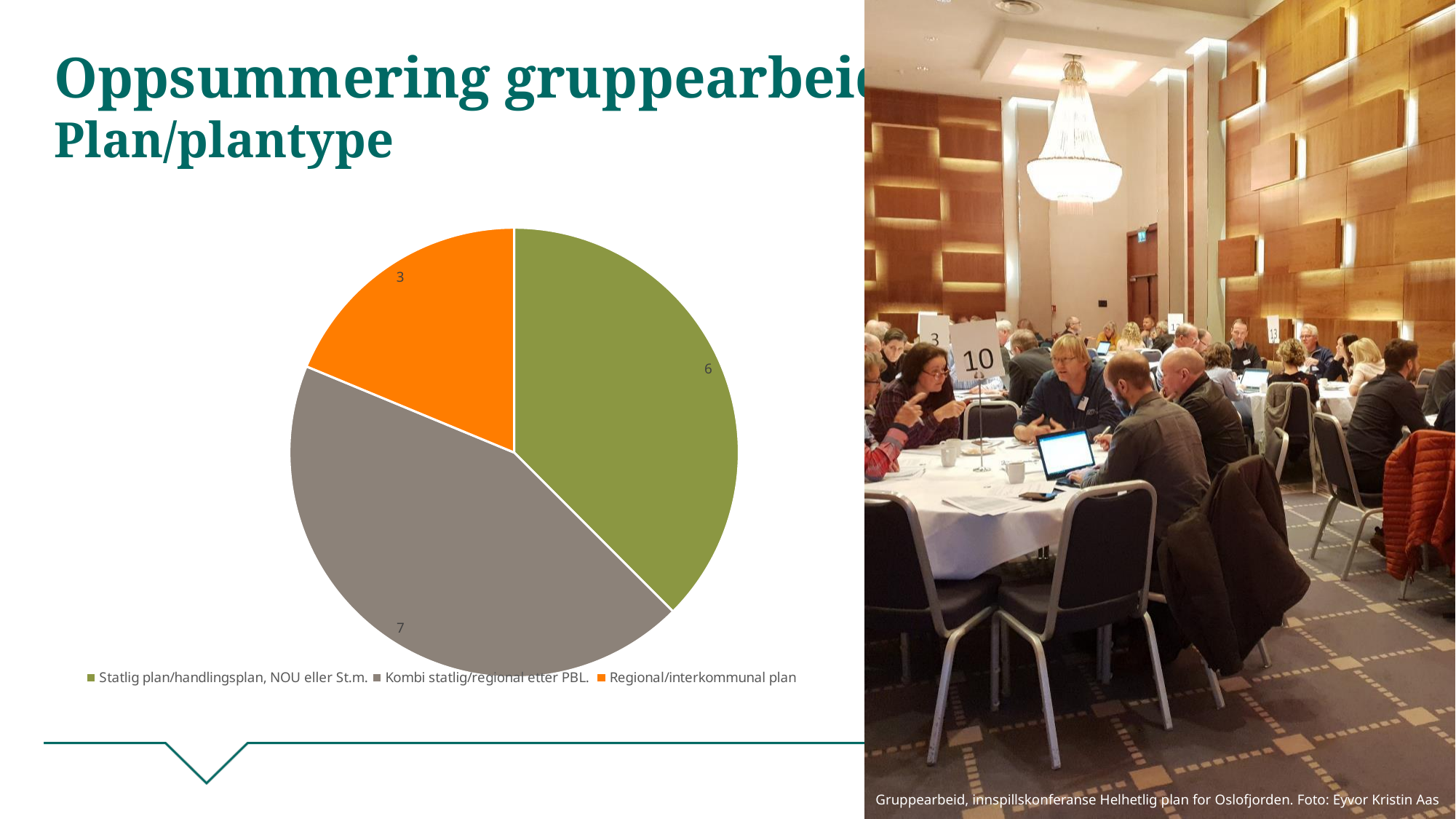
How many slices does the pie chart have? 3 What is the value for Kombi statlig/regional etter PBL.? 7 Which category has the largest slice of the pie? Kombi statlig/regional etter PBL. Which colour represents Regional/interkommunal plan in the pie chart? Orange What is the total of all the slices in the pie chart? 16 Which category has the smallest slice of the pie? Regional/interkommunal plan What is the value for Statlig plan/handlingsplan, NOU eller St.m.? 6 What kind of chart is shown on the slide? Pie chart What is the value for Regional/interkommunal plan? 3 What is the difference between the values for Kombi statlig/regional etter PBL. and Regional/interkommunal plan? 4 Which is larger: the value for Statlig plan/handlingsplan, NOU eller St.m. or the value for Regional/interkommunal plan? Statlig plan/handlingsplan, NOU eller St.m.